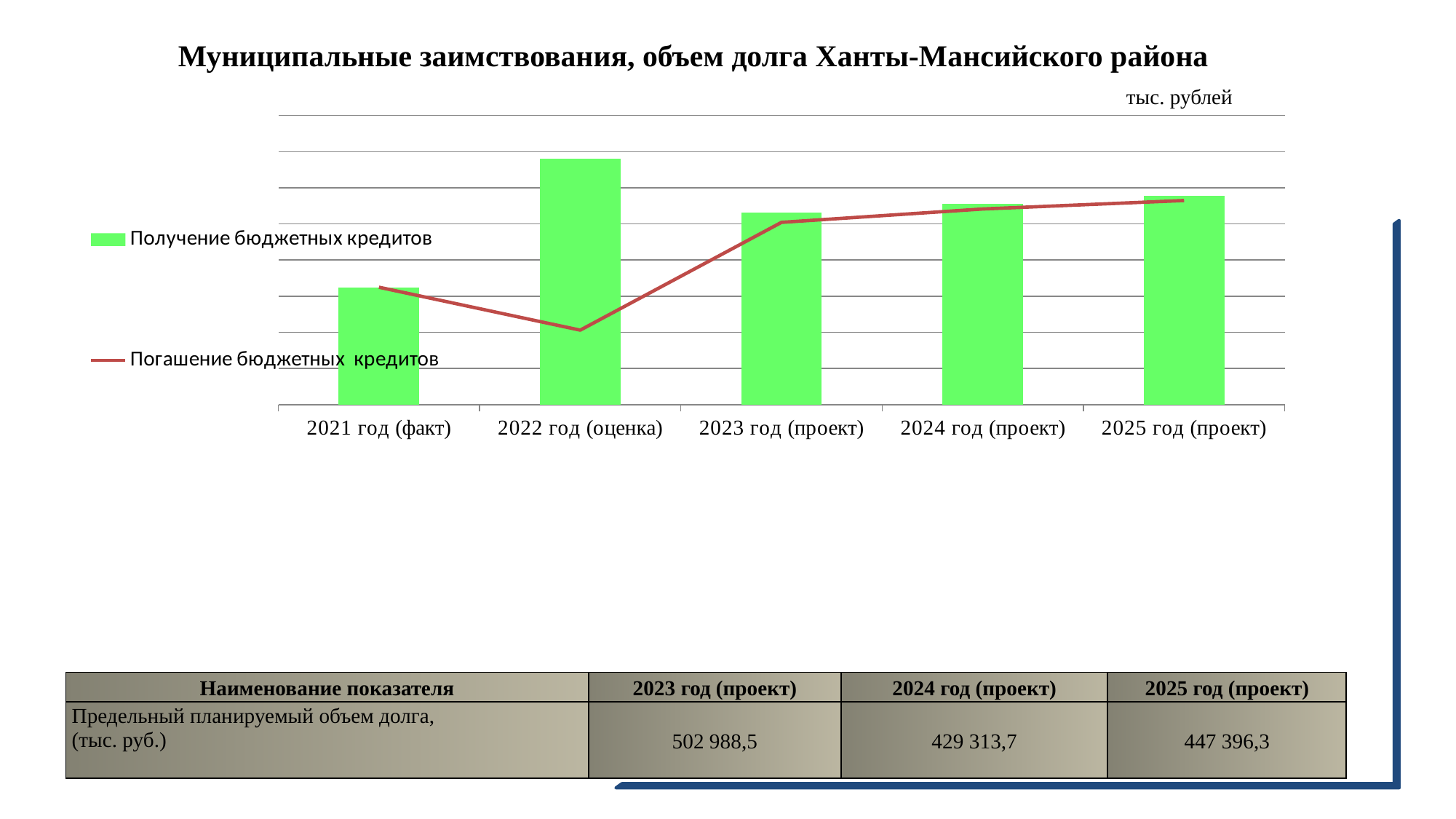
What kind of chart is shown on the slide? Combined bar and line chart Which year has the shortest bar for Получение бюджетных кредитов? 2021 год (факт) How many series does the chart legend list? 2 What colour are the bars for Получение бюджетных кредитов? Green Which is larger, the Получение бюджетных кредитов bar for 2021 год (факт) or for 2025 год (проект)? 2025 год (проект) Does the Погашение бюджетных кредитов line rise or fall from 2021 год (факт) to 2022 год (оценка)? falls In which year is the Погашение бюджетных кредитов line at its lowest point? 2022 год (оценка) Which is larger, the Получение бюджетных кредитов bar for 2022 год (оценка) or for 2023 год (проект)? 2022 год (оценка) Which year has the tallest bar for Получение бюджетных кредитов? 2022 год (оценка) Does the Погашение бюджетных кредитов line rise or fall from 2022 год (оценка) to 2025 год (проект)? rises How many year categories are shown on the x axis of the chart? 5 Is the Погашение бюджетных кредитов value higher in 2021 год (факт) or in 2023 год (проект)? 2023 год (проект)